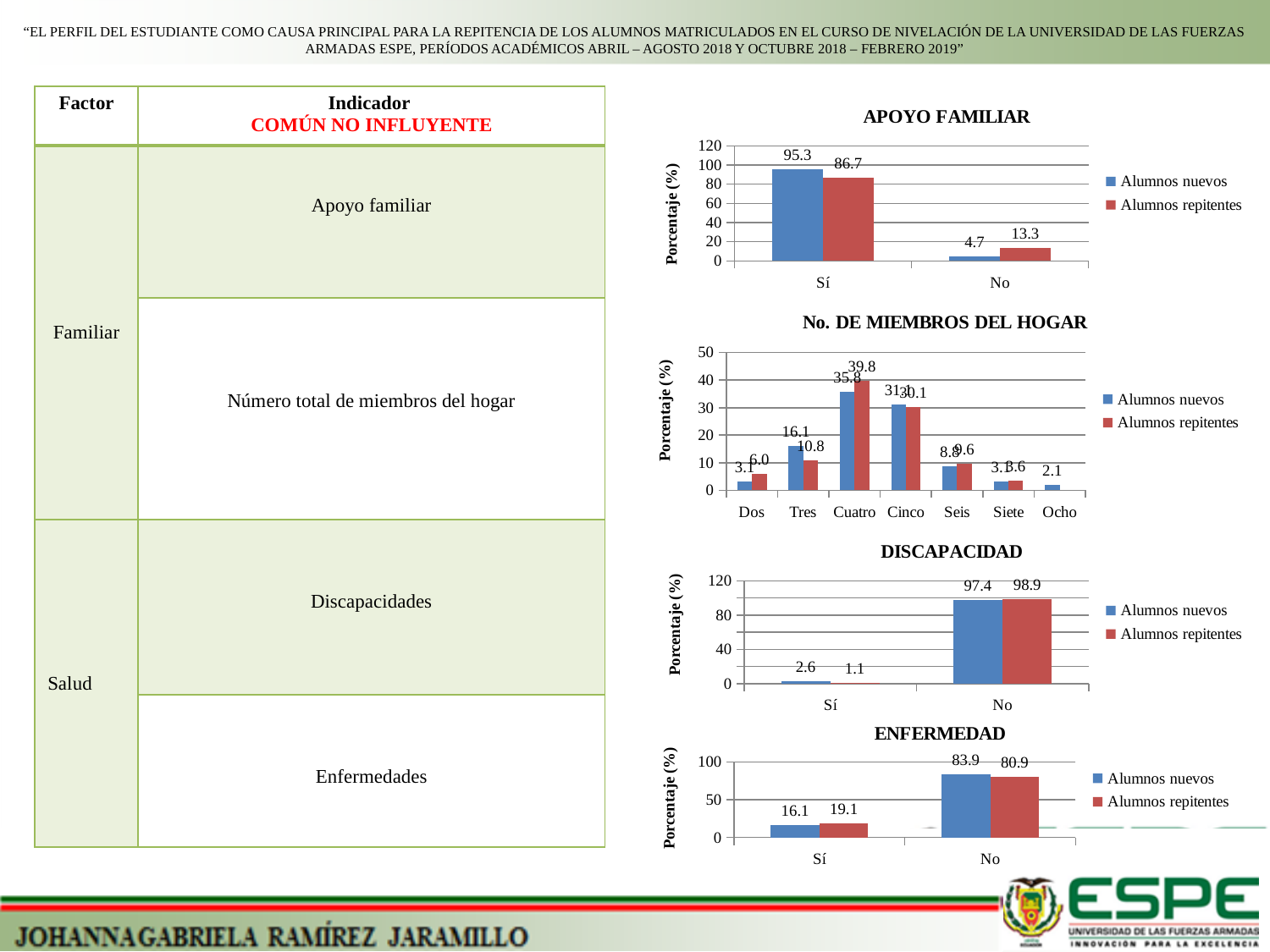
In the APOYO FAMILIAR chart, what is the value for Alumnos nuevos in the Sí category? 95.3 In the No. DE MIEMBROS DEL HOGAR chart, which household size has the highest value for Alumnos nuevos? Cuatro In the DISCAPACIDAD chart, what is the difference between Alumnos nuevos and Alumnos repitentes in the Sí category? 1.5 In the DISCAPACIDAD chart, what is the value for Alumnos repitentes in the No category? 98.9 In the APOYO FAMILIAR chart, what is the value for Alumnos repitentes in the No category? 13.3 In the ENFERMEDAD chart, what is the value for Alumnos nuevos in the No category? 83.9 How many series does the legend of the ENFERMEDAD chart list? 2 In the No. DE MIEMBROS DEL HOGAR chart, how many household-size categories are shown on the x axis? 7 In the ENFERMEDAD chart, is the value for Alumnos repitentes in the Sí category greater or less than 50? less In the APOYO FAMILIAR chart, what is the difference between Alumnos nuevos and Alumnos repitentes in the Sí category? 8.6 In the No. DE MIEMBROS DEL HOGAR chart, what is the value for Alumnos repitentes for Cuatro? 39.8 In the No. DE MIEMBROS DEL HOGAR chart, which is larger for Tres: Alumnos nuevos or Alumnos repitentes? Alumnos nuevos